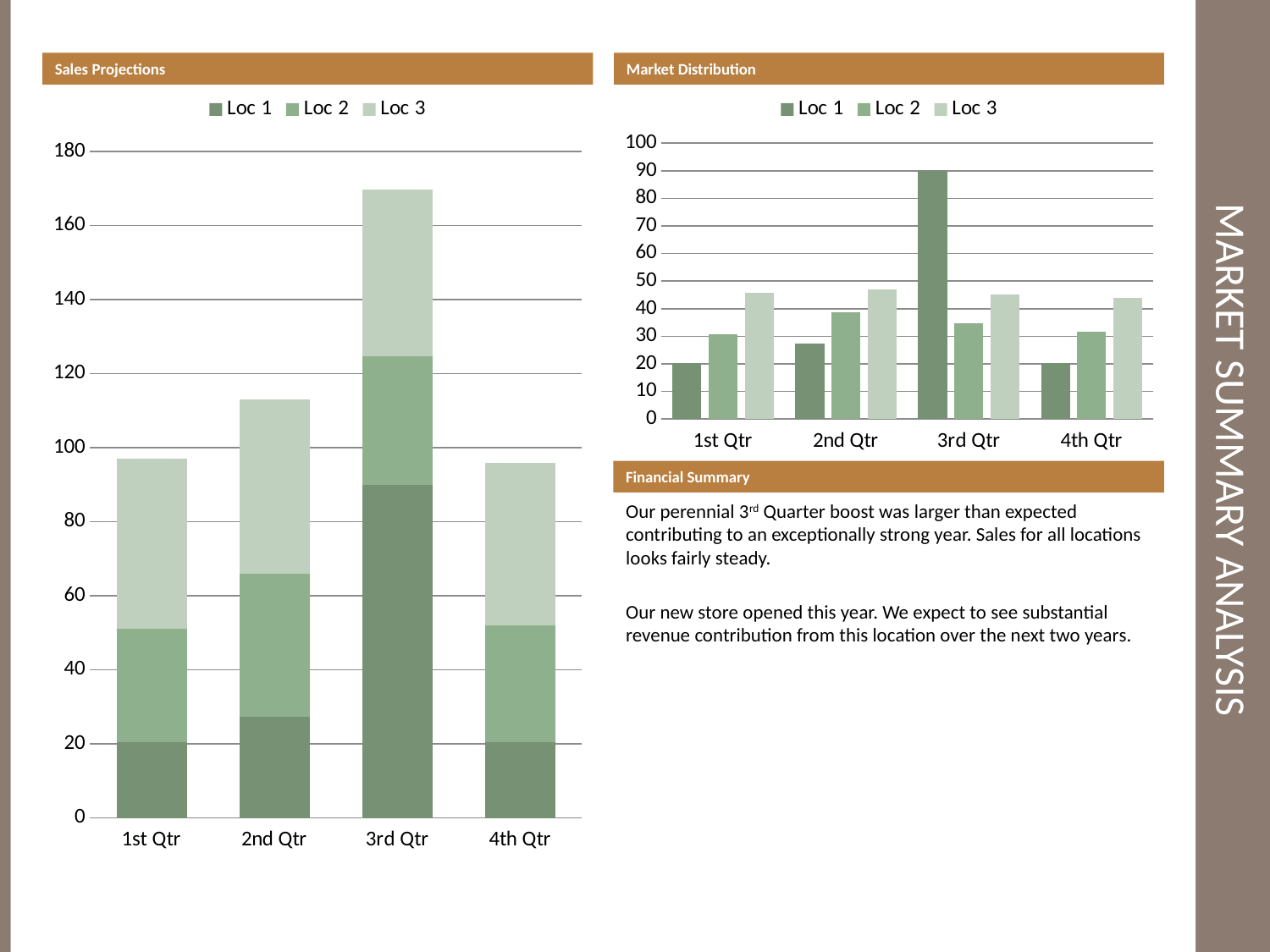
What are the legend entries of the Sales Projections chart? Loc 1, Loc 2, Loc 3 In the Sales Projections chart, is the total height of the 2nd Qtr stacked bar greater or less than 100? greater In the Market Distribution chart, is the value for Loc 3 in the 1st Qtr greater or less than 40? greater In the Market Distribution chart, which is larger in the 3rd Qtr: Loc 1 or Loc 3? Loc 1 In the Market Distribution chart, what is the value for Loc 1 in the 3rd Qtr? 90 In the Sales Projections chart, is the total height of the 3rd Qtr stacked bar greater or less than 160? greater In the Sales Projections chart, which quarter has the tallest stacked bar? 3rd Qtr What kind of chart is the Sales Projections chart? Stacked bar chart How many series does the legend of the Market Distribution chart list? 3 How many quarters are shown on the x axis of the Sales Projections chart? 4 In the Market Distribution chart, which quarter has the highest value for Loc 1? 3rd Qtr